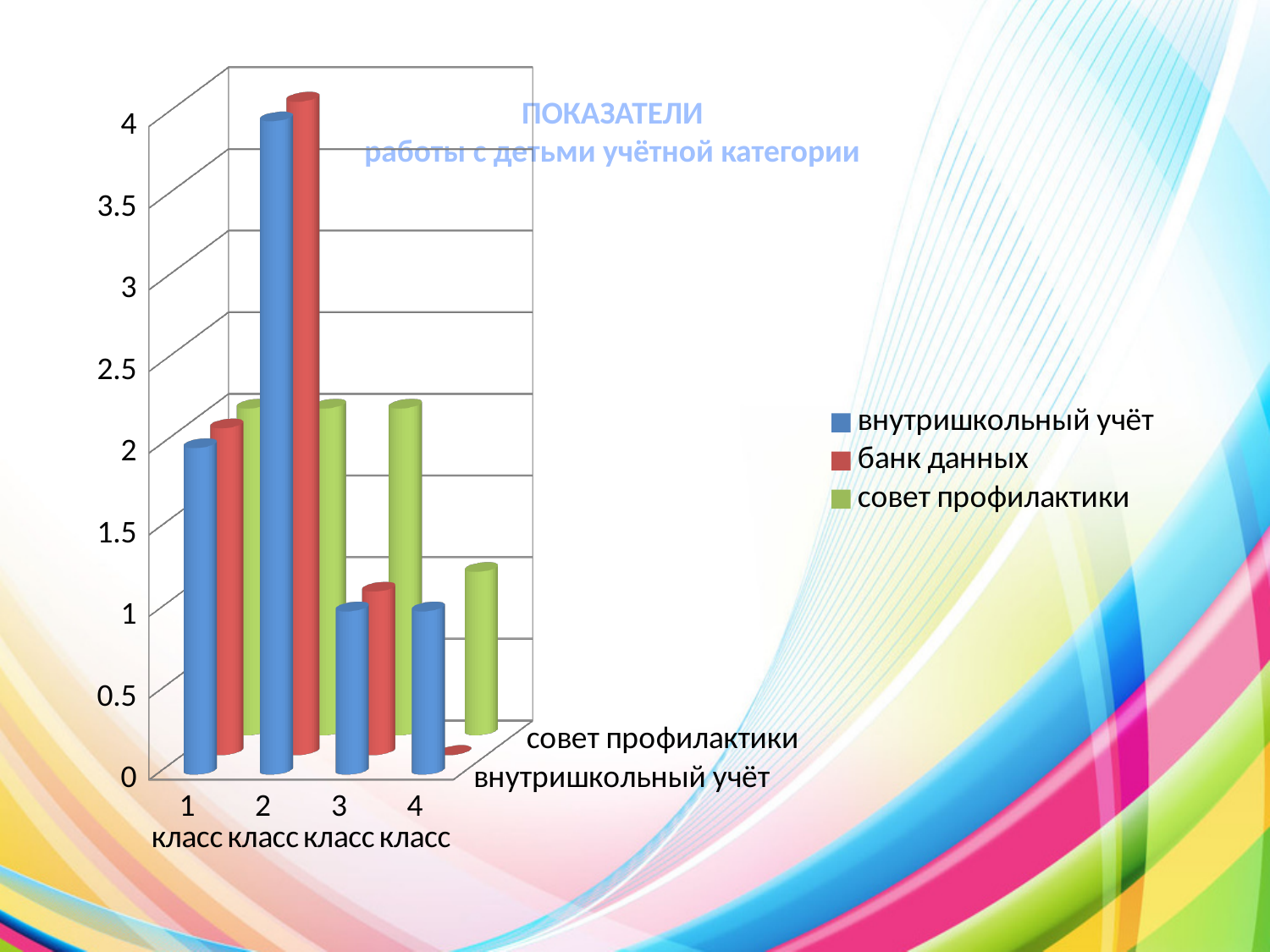
How many class categories are shown on the x axis? 4 How many series does the legend list? 3 What kind of chart is shown on the slide? bar chart Is the value for внутришкольный учёт in 3 класс greater or less than 2? less Is the value for внутришкольный учёт in 2 класс greater or less than 3? greater Which class has the highest value for внутришкольный учёт? 2 класс Is the value for совет профилактики in 4 класс greater or less than 2? less Which class has the highest value for банк данных? 2 класс Which class has the lowest value for банк данных? 4 класс Which series is shown in green in the legend? совет профилактики Which is larger for внутришкольный учёт: the value for 1 класс or the value for 3 класс? 1 класс What is the first word of the chart title? ПОКАЗАТЕЛИ